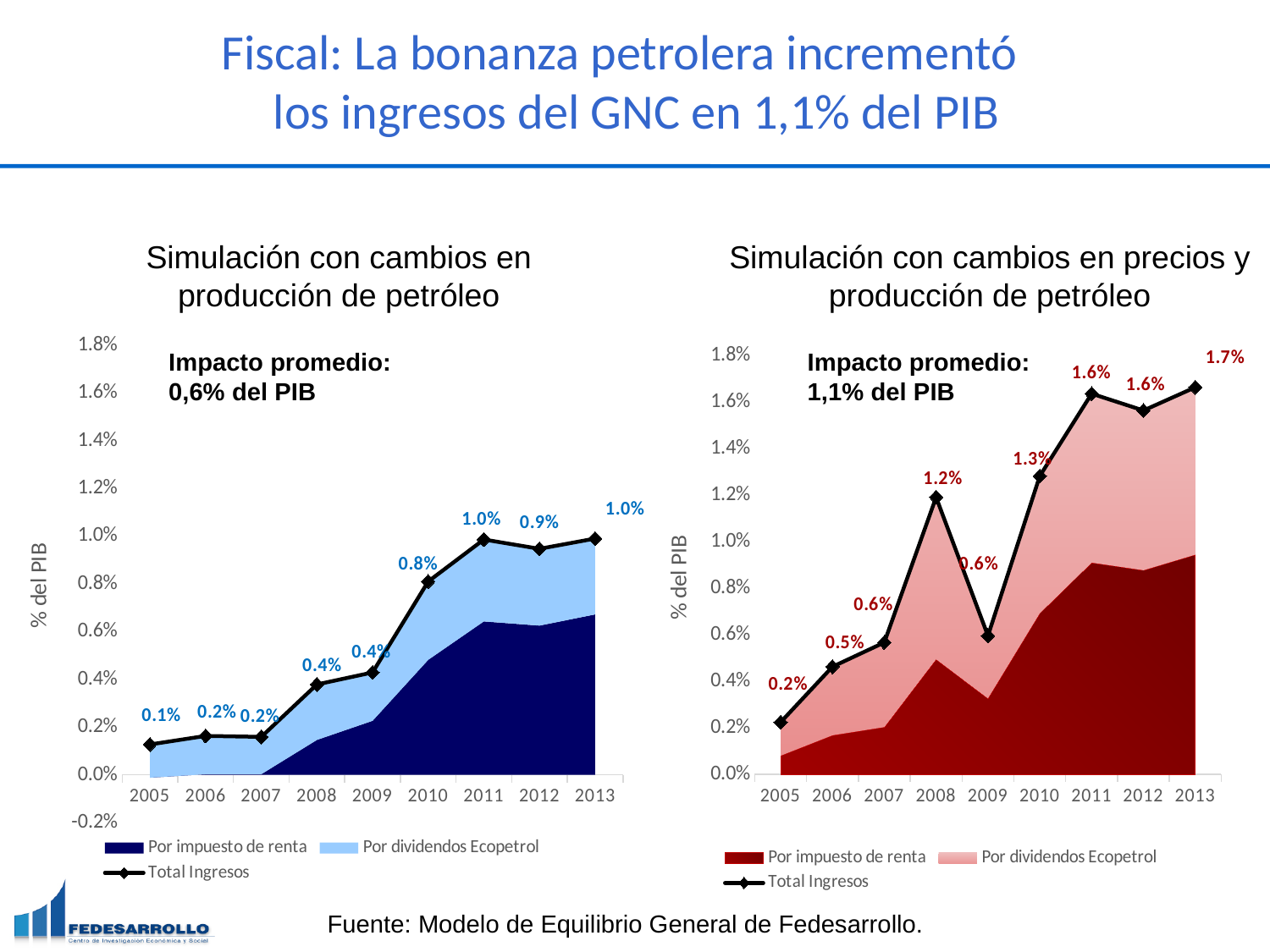
How many years are shown on the x axis of the left chart (Simulación con cambios en producción de petróleo)? 9 In the left chart (Simulación con cambios en producción de petróleo), which year has the lowest Total Ingresos value? 2005 In the right chart (Simulación con cambios en precios y producción de petróleo), what is the difference between the Total Ingresos values for 2013 and 2005? 1.5% What kind of chart is the left chart (Simulación con cambios en producción de petróleo)? Stacked area chart with a line In the right chart (Simulación con cambios en precios y producción de petróleo), is the Por impuesto de renta value for 2013 greater or less than 0.8%? greater In the right chart (Simulación con cambios en precios y producción de petróleo), which year has the larger Total Ingresos value, 2008 or 2009? 2008 In the right chart (Simulación con cambios en precios y producción de petróleo), does the Total Ingresos line generally rise or fall from 2005 to 2013? Rise In the right chart (Simulación con cambios en precios y producción de petróleo), what is the Total Ingresos value for 2008? 1.2% How many series does the legend of the right chart (Simulación con cambios en precios y producción de petróleo) list? 3 In the left chart (Simulación con cambios en producción de petróleo), what is the Total Ingresos value for 2010? 0.8% What average impact (Impacto promedio) is stated on the left chart (Simulación con cambios en producción de petróleo)? 0,6% del PIB In the right chart (Simulación con cambios en precios y producción de petróleo), which year has the highest Total Ingresos value? 2013